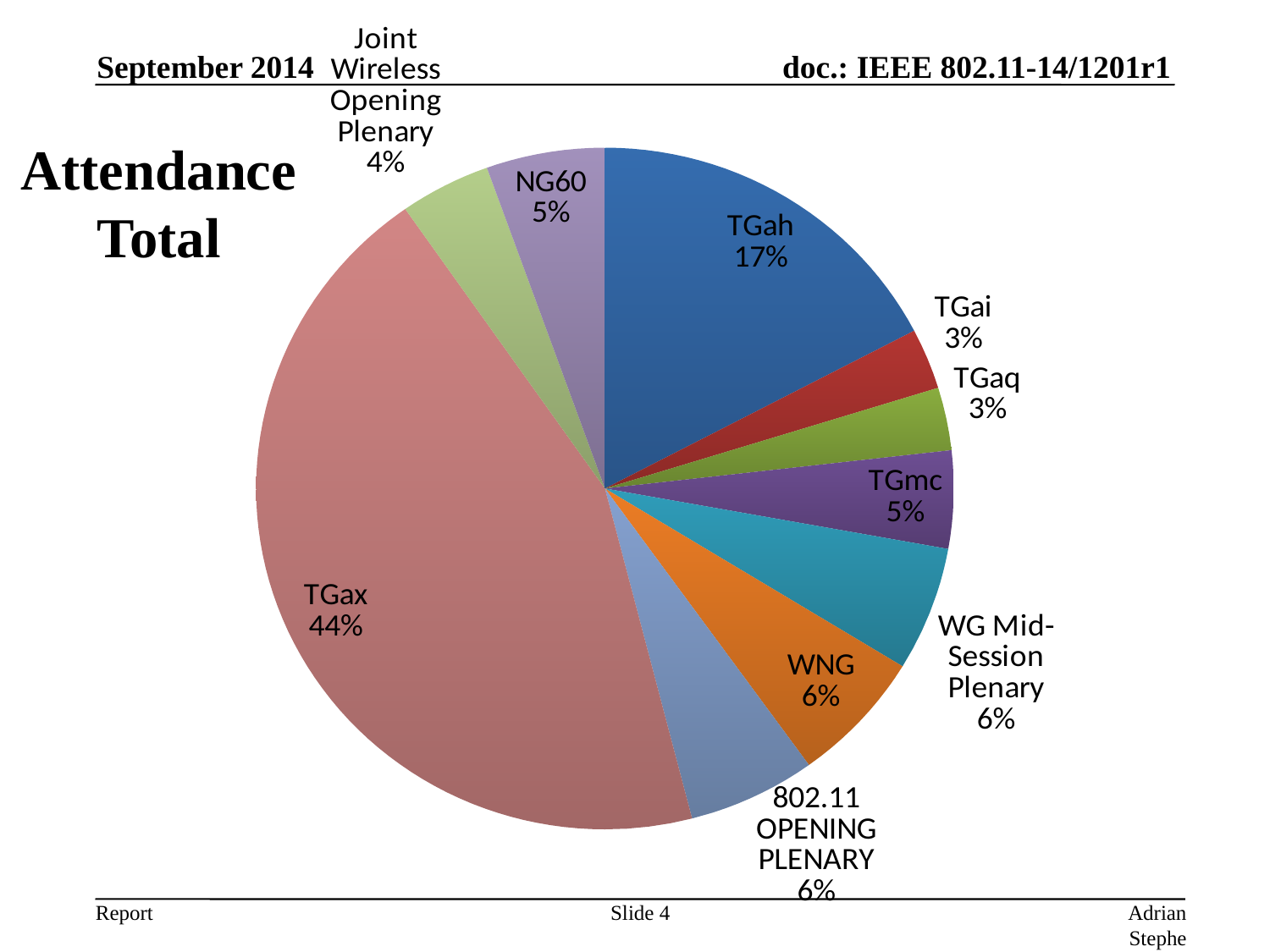
Which is larger, the share for TGmc or the share for TGah? TGah What percentage is shown for NG60? 5% Which group has the largest slice of the pie? TGax What kind of chart is shown on the slide? pie chart What is the difference in percentage points between TGax and TGah? 27 How many slices does the pie chart have? 10 What percentage is shown for TGai? 3% What is the title of the chart? Attendance Total What percentage is shown for the Joint Wireless Opening Plenary? 4% What share of attendance does TGah have? 17% What percentage is shown for WNG? 6% What share of attendance does TGax have? 44%